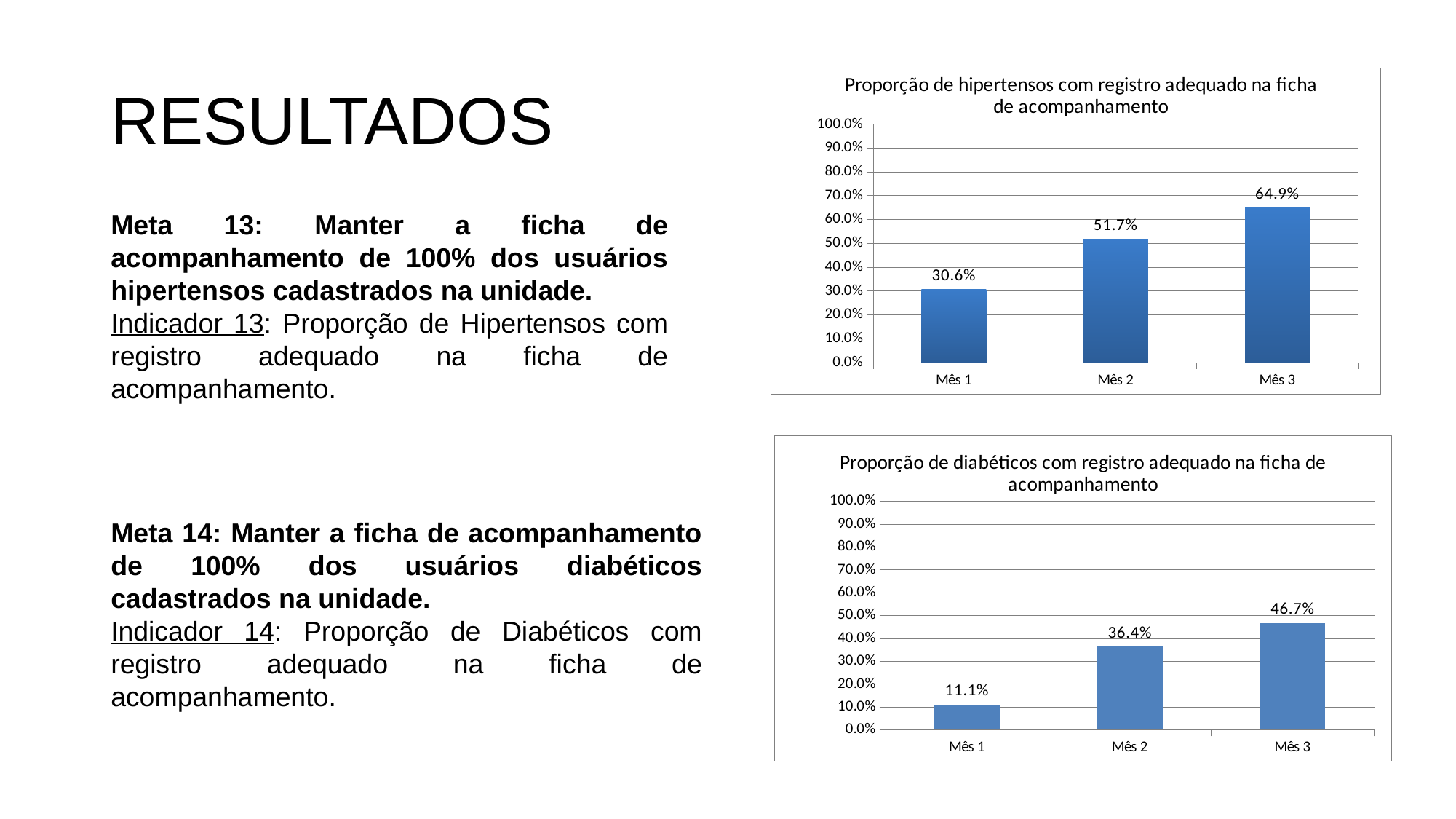
In the bottom chart (diabéticos), what is the difference between the values for Mês 2 and Mês 1? 25.3% In the top chart (hipertensos), do the values rise or fall from Mês 1 to Mês 3? rise Which is larger: the Mês 2 value in the top chart (hipertensos) or the Mês 2 value in the bottom chart (diabéticos)? Top chart (hipertensos), 51.7% In the top chart (hipertensos), which month has the highest value? Mês 3 In the top chart (hipertensos), which month has the lowest value? Mês 1 In the bottom chart (diabéticos), is the value for Mês 3 greater or less than 50.0%? less In the bottom chart (Proporção de diabéticos com registro adequado na ficha de acompanhamento), what is the value for Mês 1? 11.1% In the top chart (Proporção de hipertensos com registro adequado na ficha de acompanhamento), what is the value for Mês 2? 51.7% In the bottom chart (diabéticos), what is the value for Mês 3? 46.7% In the top chart (hipertensos), what is the difference between the values for Mês 3 and Mês 1? 34.3% In the bottom chart (diabéticos), which month has the highest value? Mês 3 How many categories are shown on the x axis of the bottom chart (diabéticos)? 3